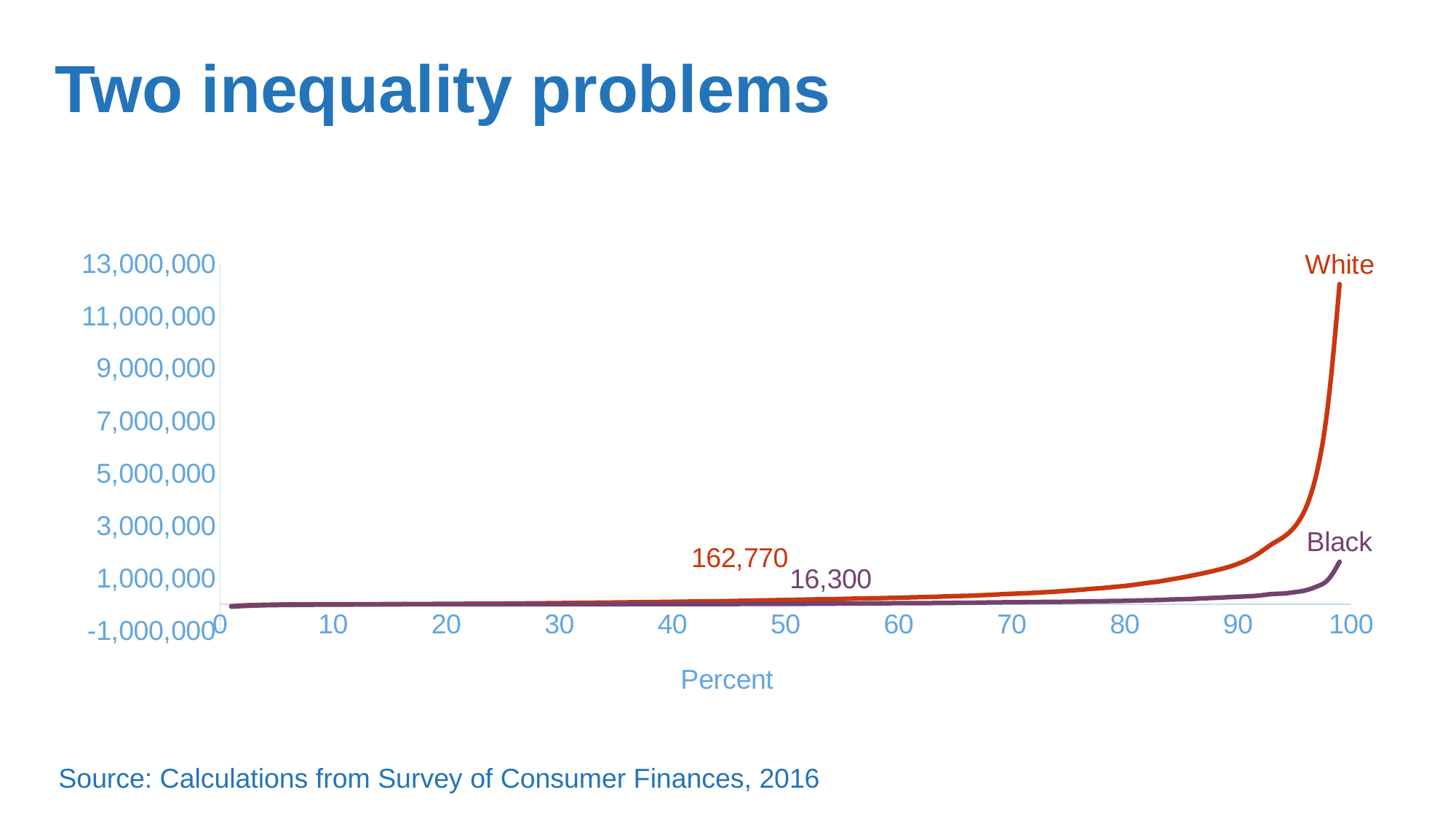
What is the label of the x axis? Percent What are the names of the two series plotted on the chart? White and Black Is the value of the White line at its right end greater or less than 11,000,000? greater What value is printed as the data label on the White line? 162,770 Which labelled value is larger, the White label of 162,770 or the Black label of 16,300? White (162,770) Do the values of the White line rise or fall as the percent increases along the x axis? rise Is the value of the Black line at its right end greater or less than 3,000,000? less Which series reaches the highest value at the right end of the chart? White What value is printed as the data label on the Black line? 16,300 What kind of chart is shown on the slide? line chart How many series are plotted on the chart? 2 What is the difference between the labelled White value (162,770) and the labelled Black value (16,300)? 146,470